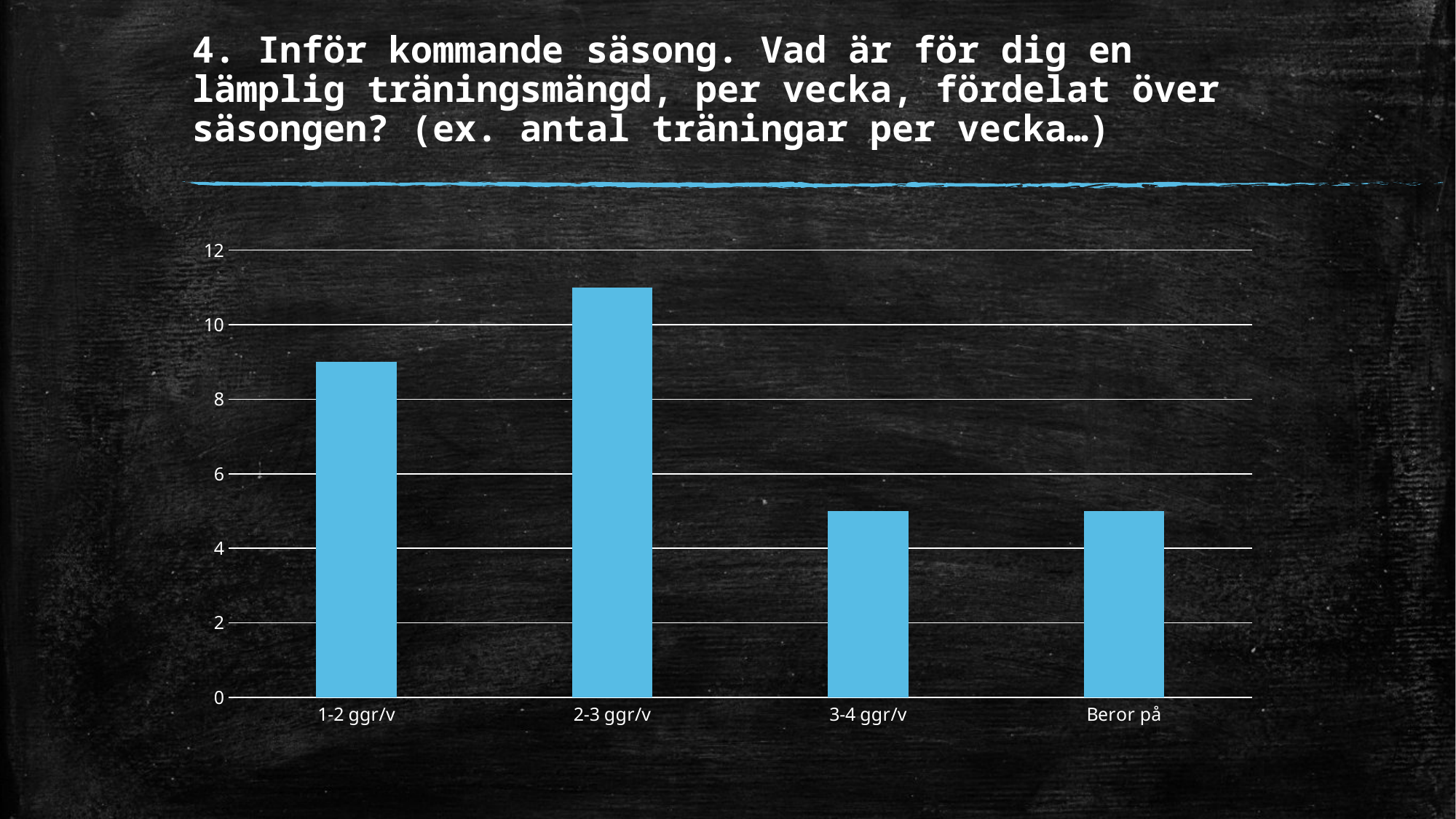
Is the value for Beror på greater or less than 4? greater What is the highest value shown on the y axis of the chart? 12 Is the value for 3-4 ggr/v greater or less than 6? less What kind of chart is shown on the slide? bar chart Is the value for 1-2 ggr/v greater or less than 8? greater Which is larger, the value for 1-2 ggr/v or the value for 3-4 ggr/v? 1-2 ggr/v Which category has the highest bar in the chart? 2-3 ggr/v How many categories are shown on the x axis of the chart? 4 Which is larger, the value for 2-3 ggr/v or the value for Beror på? 2-3 ggr/v What colour are the bars in the chart? blue